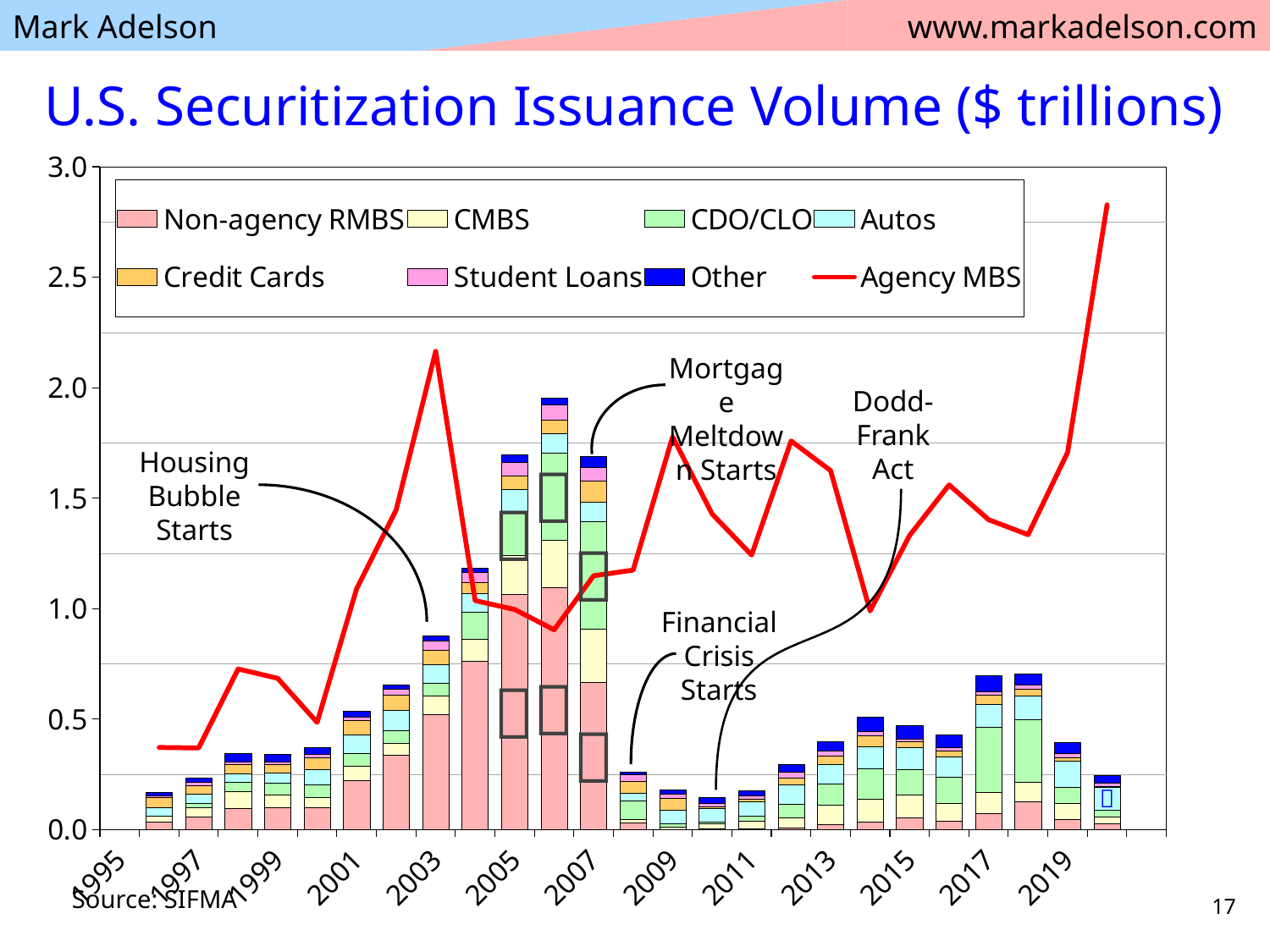
How many series does the legend list? 8 Which is larger, the Agency MBS value for 2003 or for 2009? 2003 Which series is drawn as a line rather than as stacked bars? Agency MBS Which stacked bar is taller, 2017 or 2019? 2017 What is the title of the chart? U.S. Securitization Issuance Volume ($ trillions) Is the Agency MBS value for 2019 greater or less than 1.5? greater What kind of chart is shown on the slide? bar chart with a line Is the total height of the stacked bar for 2005 greater or less than 1.5? greater Does the Agency MBS line rise or fall from 2017 to the end of the series? rise Do the stacked bar totals rise or fall from 2009 to 2013? rise Is the Agency MBS value for 2003 greater or less than 2.0? greater